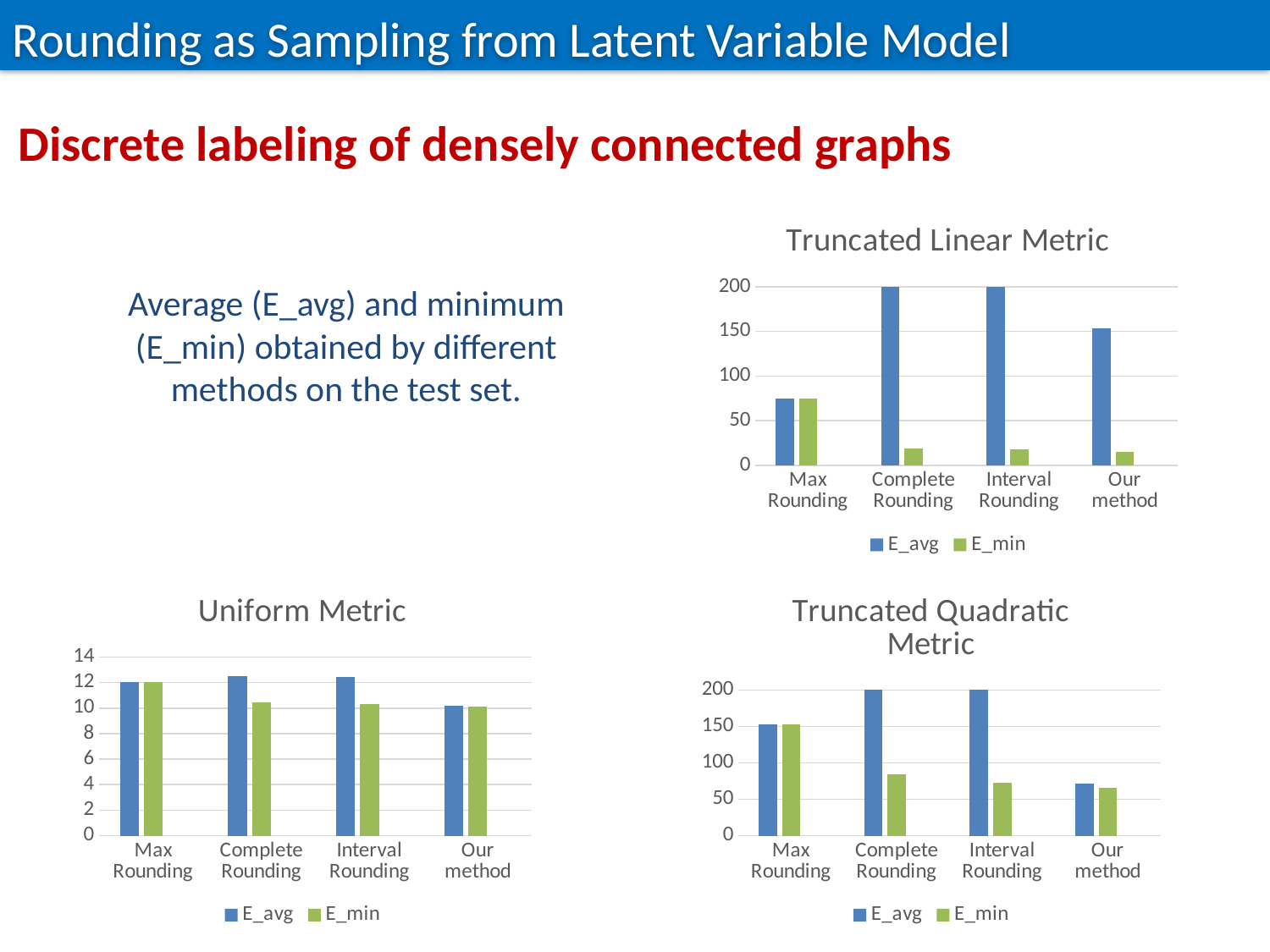
In the Truncated Linear Metric chart, which category has the highest E_min value? Max Rounding In the Truncated Linear Metric chart, how many series does the legend list? 2 In the Truncated Linear Metric chart, is the E_min value for Complete Rounding greater or less than 50? less In the Uniform Metric chart, which is larger for Complete Rounding, E_avg or E_min? E_avg In the Truncated Quadratic Metric chart, is the E_avg value for Our method greater or less than 100? less In the Truncated Quadratic Metric chart, which category has the lowest E_avg value? Our method What kind of chart is the Uniform Metric chart? bar chart In the Uniform Metric chart, how many categories are shown on the x axis? 4 In the Truncated Linear Metric chart, is the E_avg value for Our method greater or less than 100? greater How many charts are on the slide? 3